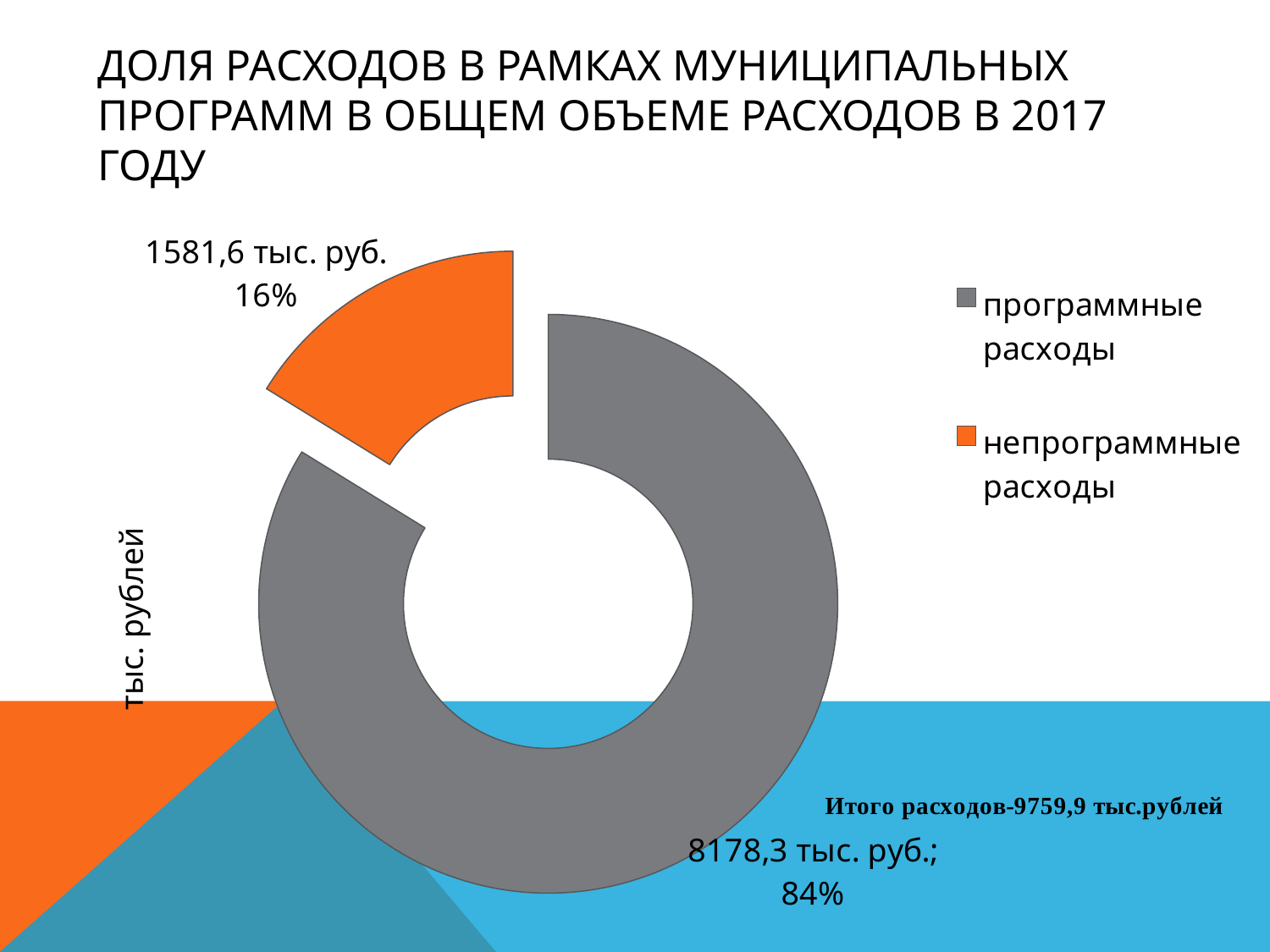
What share of total expenses do программные расходы make up? 84% Which category has the largest slice? программные расходы What share of total expenses do непрограммные расходы make up? 16% What is the total of all expenses shown on the slide? 9759,9 тыс.рублей What is the difference between программные расходы and непрограммные расходы in тыс. руб.? 6596,7 тыс. руб. Which category has the smallest slice? непрограммные расходы What is the value for программные расходы? 8178,3 тыс. руб. What is the value for непрограммные расходы? 1581,6 тыс. руб. How many categories does the chart show? 2 What kind of chart is shown on the slide? doughnut chart What colour is the slice for непрограммные расходы? orange Which is larger, программные расходы or непрограммные расходы? программные расходы